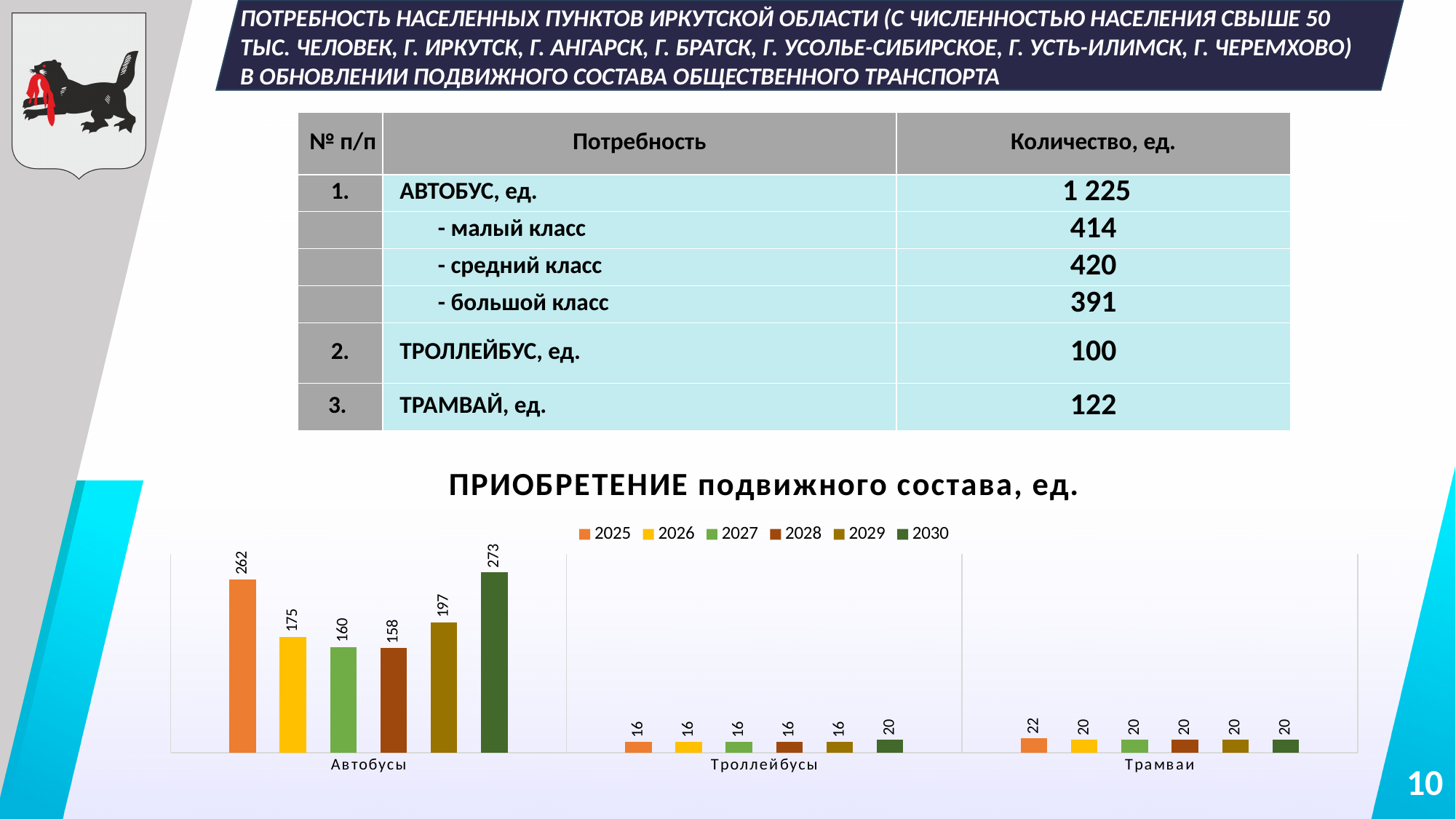
How many series does the chart legend list? 6 What is the value for Трамваи in 2025? 22 What is the difference between the Автобусы values for 2030 and 2025? 11 What is the value for Троллейбусы in 2030? 20 What is the value for Автобусы in 2030? 273 Which year has the lowest value for Автобусы? 2028 Which year has the highest value for Автобусы? 2030 Which is larger: the Автобусы value for 2026 or for 2029? 2029 What is the value for Автобусы in 2025? 262 What is the title of the chart? ПРИОБРЕТЕНИЕ подвижного состава, ед. What type of chart is shown on the slide? bar chart How many categories are shown on the x axis of the chart? 3